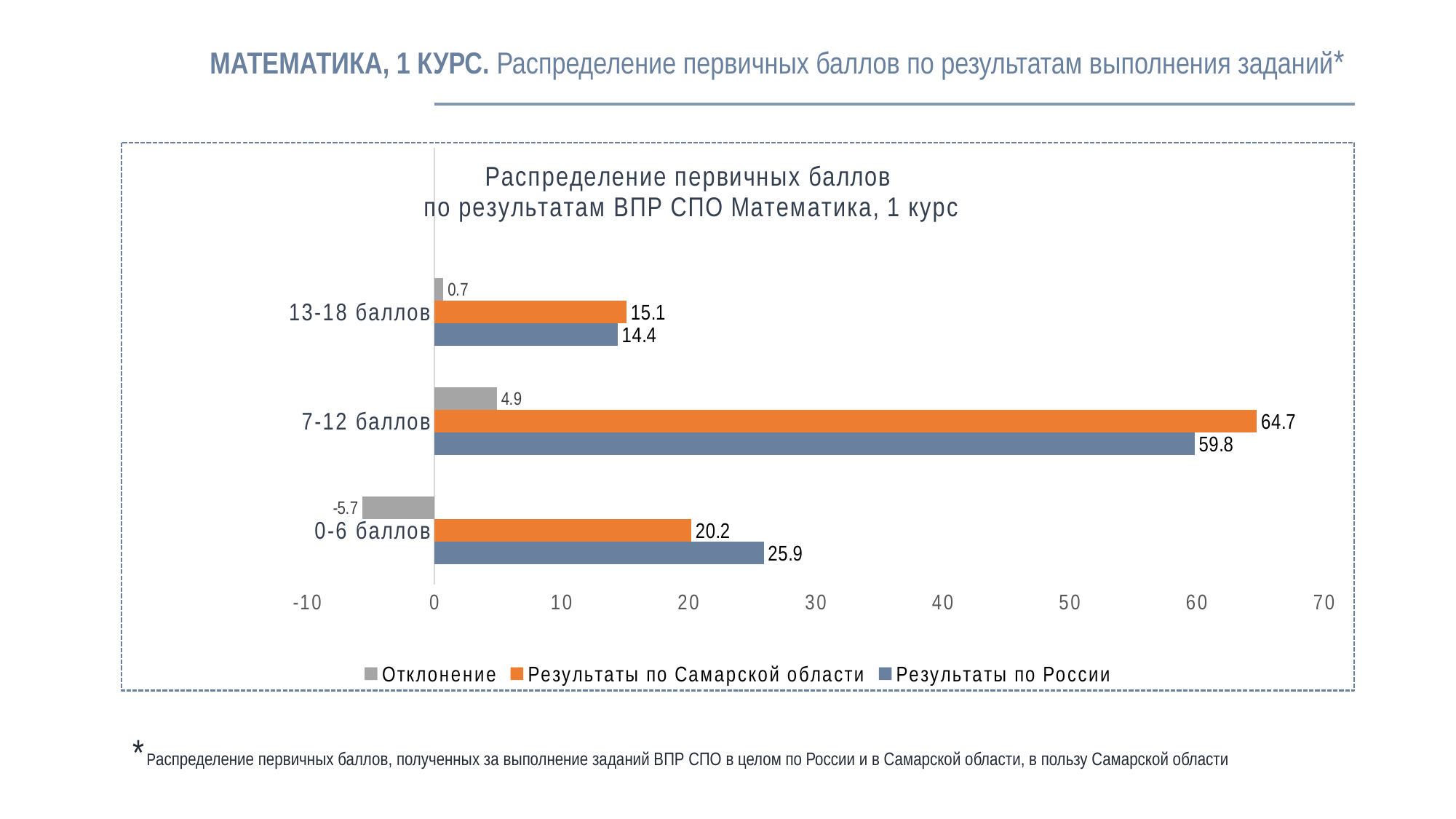
What kind of chart is shown on the slide? Bar chart Which category has the lowest value for Результаты по России? 13-18 баллов What is the value for Результаты по Самарской области in the 7-12 баллов category? 64.7 What is the value for Результаты по России in the 13-18 баллов category? 14.4 What is the Отклонение value for the 0-6 баллов category? -5.7 How many score categories are shown on the chart? 3 What is the difference between Результаты по Самарской области and Результаты по России in the 7-12 баллов category? 4.9 How many series does the legend list? 3 Is the value for Результаты по России in the 7-12 баллов category greater or less than 50? greater What is the value for Результаты по России in the 0-6 баллов category? 25.9 In the 0-6 баллов category, which is larger: Результаты по Самарской области or Результаты по России? Результаты по России Which category has the highest value for Результаты по Самарской области? 7-12 баллов